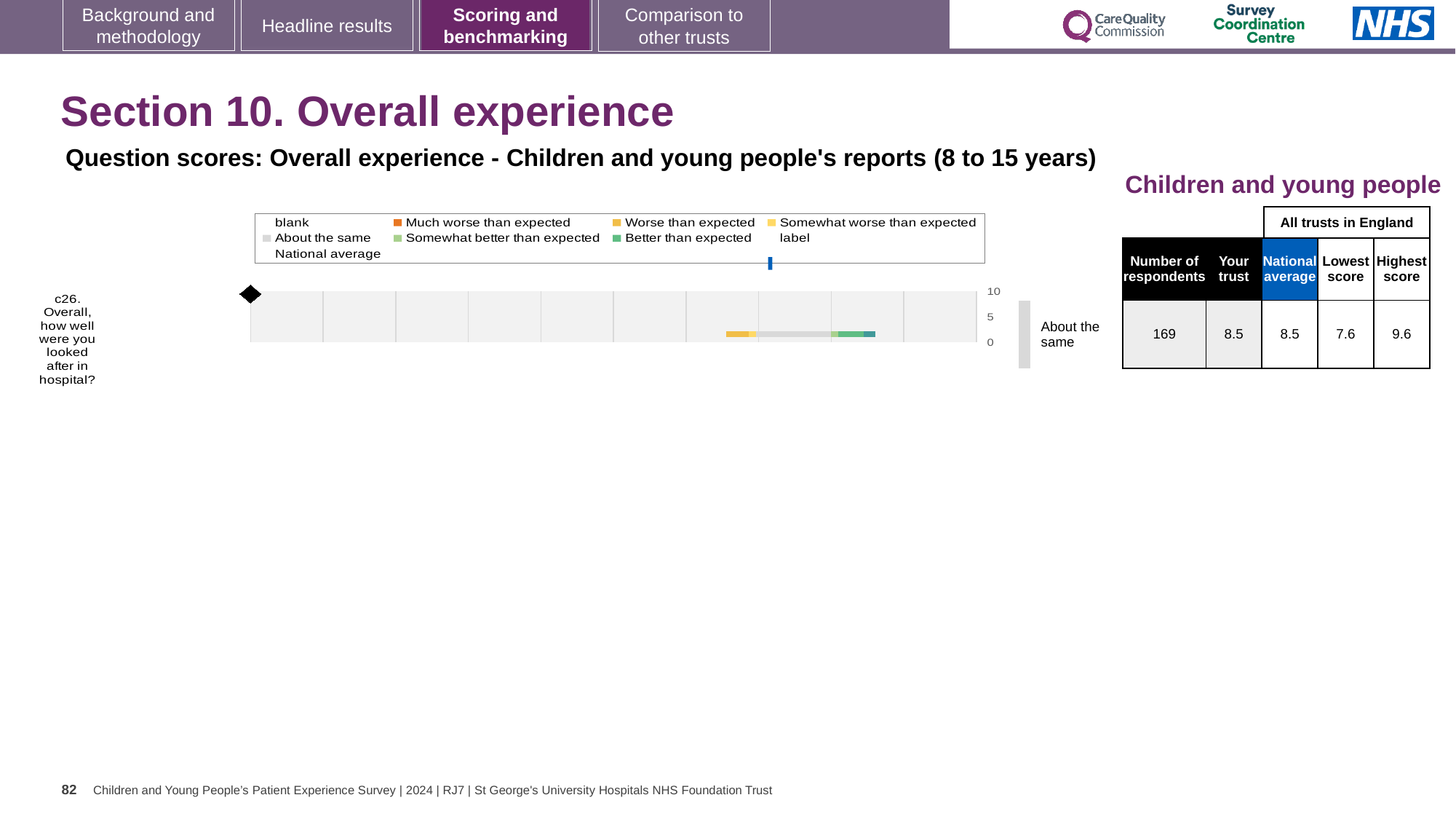
What benchmark category label is shown next to the bar for question c26? About the same What kind of chart is shown on the slide? bar chart How many survey questions are plotted in the chart? 1 How many respondents answered question c26? 169 What is the maximum value shown on the chart's score axis? 10 Which is larger for question c26: the trust's score or the lowest score in England? the trust's score What is the lowest score among all trusts in England for question c26? 7.6 What is the national average score for question c26? 8.5 What is the 'Your trust' score for question c26 (Overall, how well were you looked after in hospital?)? 8.5 What is the highest score among all trusts in England for question c26? 9.6 What is the title of the chart on the slide? Question scores: Overall experience - Children and young people's reports (8 to 15 years) What is the difference between the highest score and the lowest score for question c26? 2.0